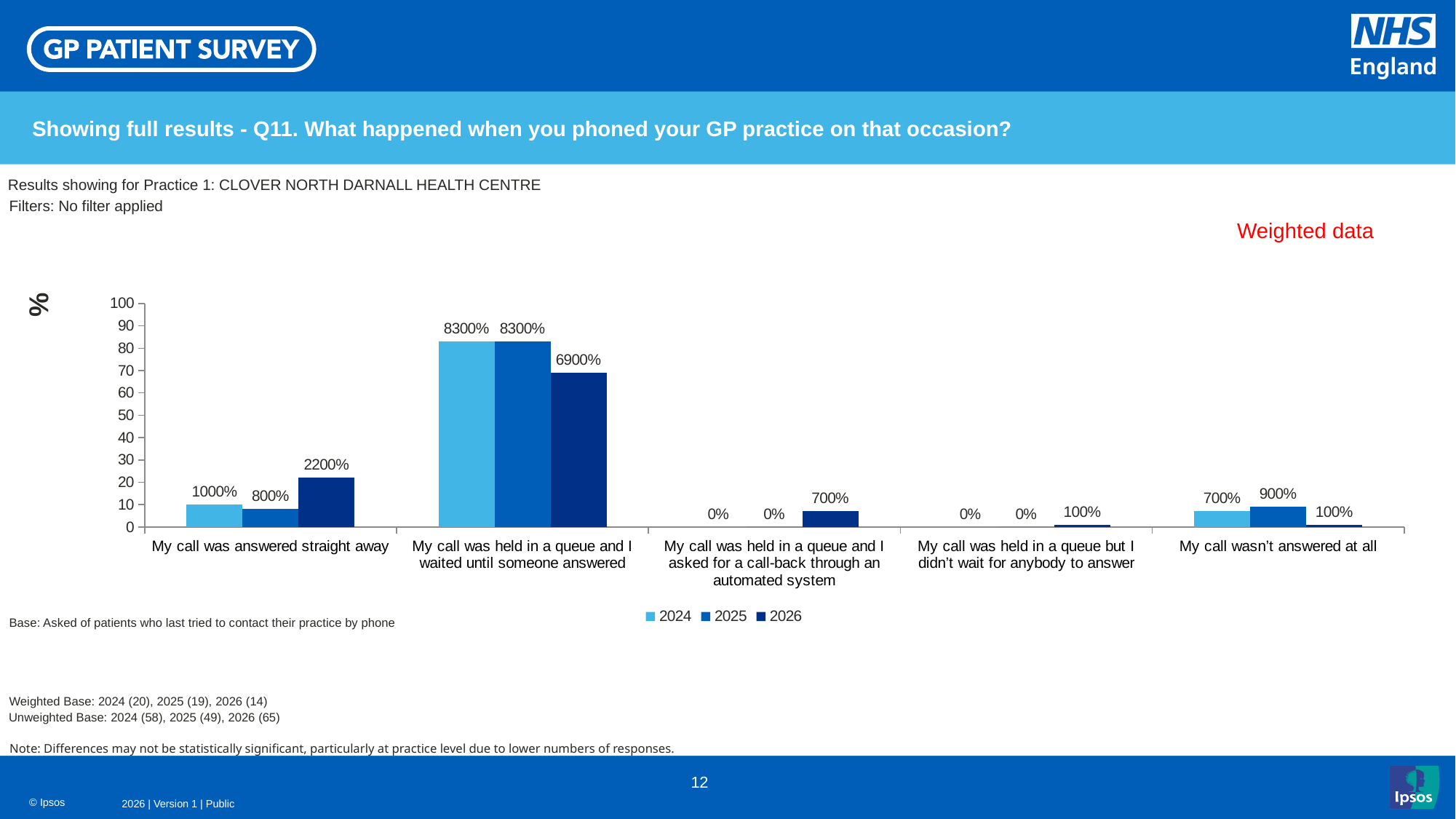
Which years are listed in the chart legend? 2024, 2025, 2026 What kind of chart is shown on the slide? Bar chart Which category has the lowest 2024 value? My call was held in a queue and I asked for a call-back through an automated system (tied with 'My call was held in a queue but I didn't wait for anybody to answer') What is the difference between the 2025 and 2026 values for 'My call was held in a queue and I waited until someone answered'? 1400% What is the 2026 value for 'My call was answered straight away'? 2200% What is the 2025 value for 'My call wasn't answered at all'? 900% How many series does the legend list? 3 How many response categories are shown on the x axis? 5 Which category has the highest 2026 value? My call was held in a queue and I waited until someone answered For 'My call was answered straight away', which year has the larger value, 2024 or 2025? 2024 What is the 2024 value for 'My call was held in a queue and I waited until someone answered'? 8300% What is the 2026 value for 'My call was held in a queue and I asked for a call-back through an automated system'? 700%